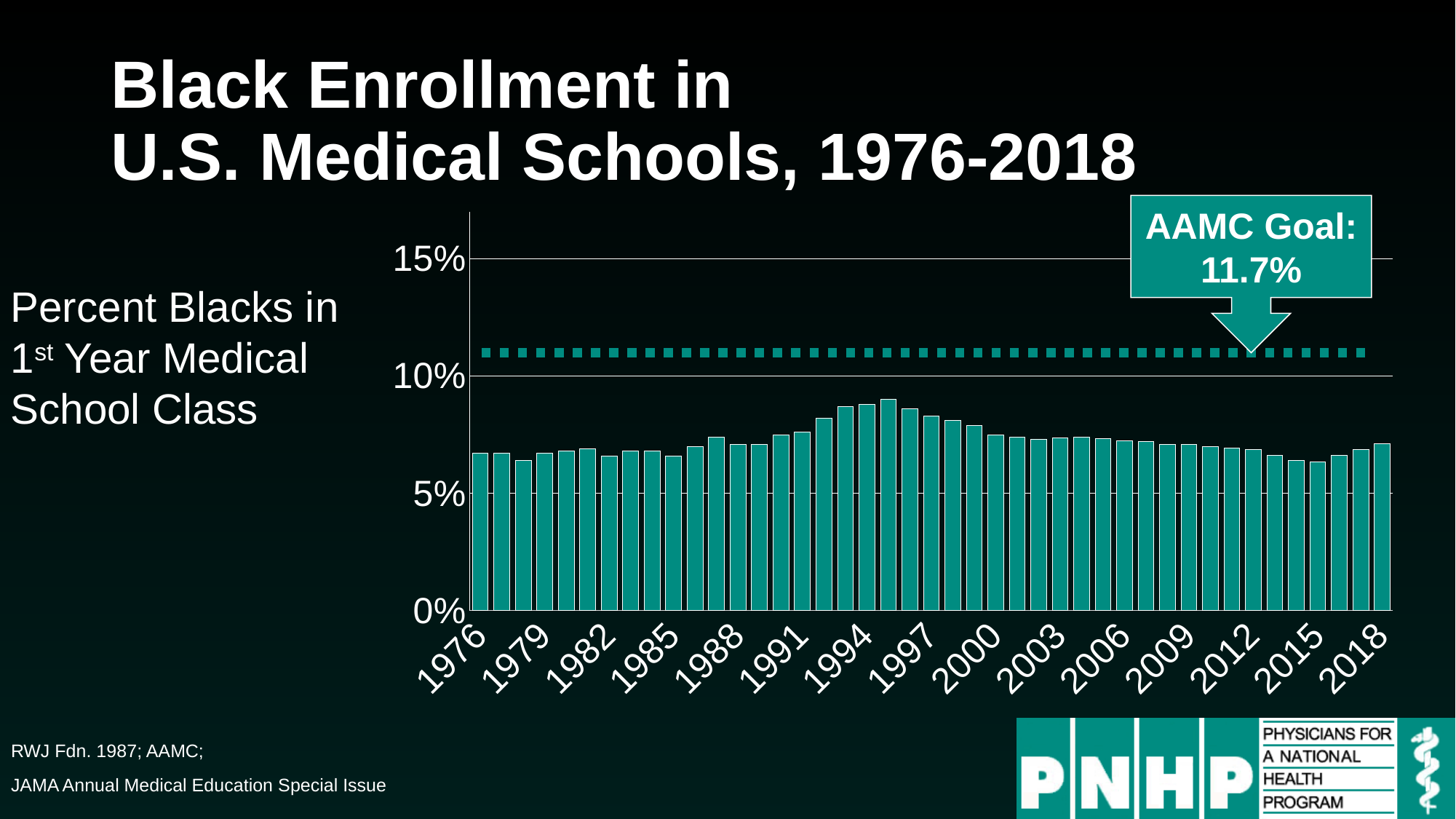
Which is larger, the value for 1994 or the value for 1976? 1994 Does any year's bar reach the AAMC goal line of 11.7%? No Do the values rise or fall from 1985 to 1994? rise Is the value for 2018 greater or less than 10%? less How many years (bars) are plotted on the chart? 43 What is the AAMC goal shown on the chart? 11.7% Is the value for 1976 greater or less than 5%? greater Do the values rise or fall from 1995 to 2015? fall Is the value for 1994 greater or less than 10%? less Which is larger, the value for 2018 or the value for 2015? 2018 What kind of chart is shown on the slide? bar chart What does the y axis of the chart measure, according to the label on the slide? Percent Blacks in 1st Year Medical School Class